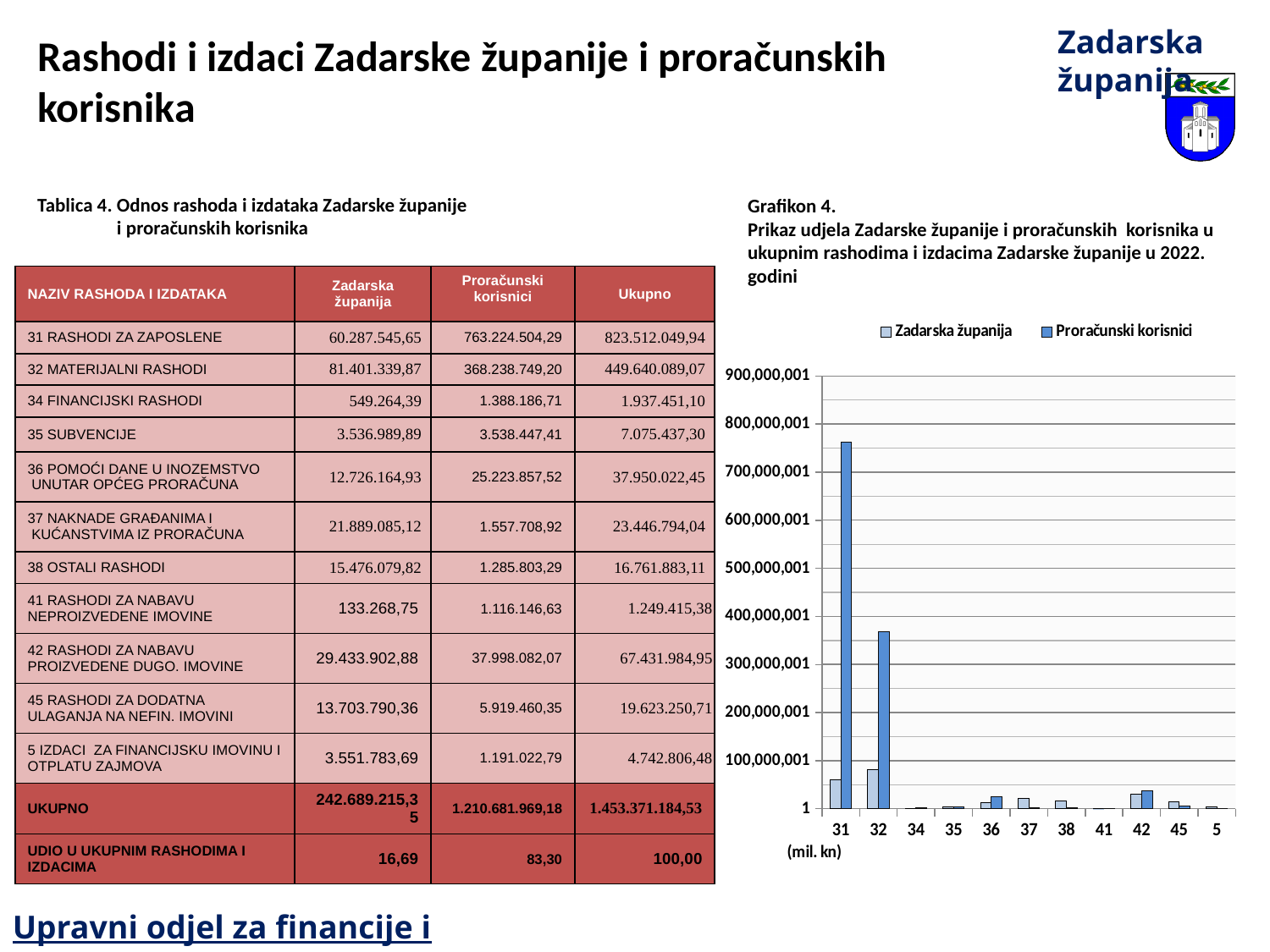
In Grafikon 4, is the Zadarska županija value for category 32 greater or less than 100,000,001? less What kind of chart is Grafikon 4 on the slide? bar chart How many series does the legend of Grafikon 4 list? 2 In Grafikon 4, for category 31, which series has the larger bar: Zadarska županija or Proračunski korisnici? Proračunski korisnici In Grafikon 4, which category has the highest bar for Proračunski korisnici? 31 In Grafikon 4, which category has the highest bar for Zadarska županija? 32 What unit label is shown below the x axis of Grafikon 4? (mil. kn) In Grafikon 4, is the Proračunski korisnici value for category 31 greater or less than 700,000,001? greater In Grafikon 4, is the Proračunski korisnici value for category 32 greater or less than 400,000,001? less In Grafikon 4, for category 37, which series has the larger bar: Zadarska županija or Proračunski korisnici? Zadarska županija How many categories are shown along the x axis of Grafikon 4? 11 What are the two legend entries of Grafikon 4? Zadarska županija, Proračunski korisnici